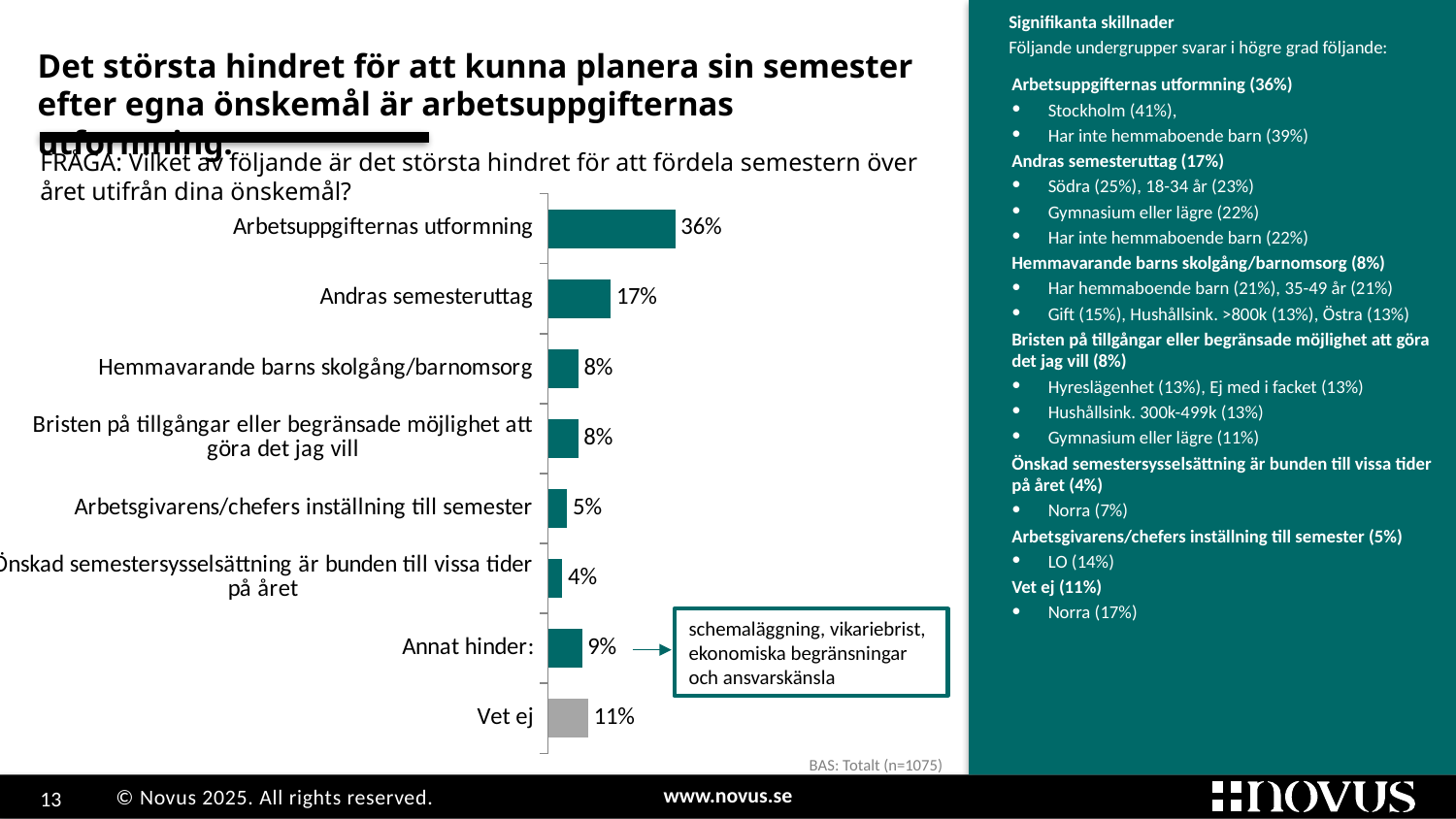
What kind of chart is shown on the slide? Bar chart What percentage is shown for "Arbetsuppgifternas utformning"? 36% What is the value for "Andras semesteruttag"? 17% Which category has the lowest value in the chart? Önskad semestersysselsättning är bunden till vissa tider på året Which is larger: "Vet ej" or "Annat hinder:"? Vet ej What is the value for "Annat hinder:"? 9% Which category has the highest value in the chart? Arbetsuppgifternas utformning What percentage is shown for "Vet ej"? 11% What is the difference between "Arbetsuppgifternas utformning" and "Andras semesteruttag"? 19 percentage points What is the value for "Arbetsgivarens/chefers inställning till semester"? 5% What is the base (BAS) sample size noted below the chart? Totalt (n=1075) How many categories are shown in the bar chart? 8